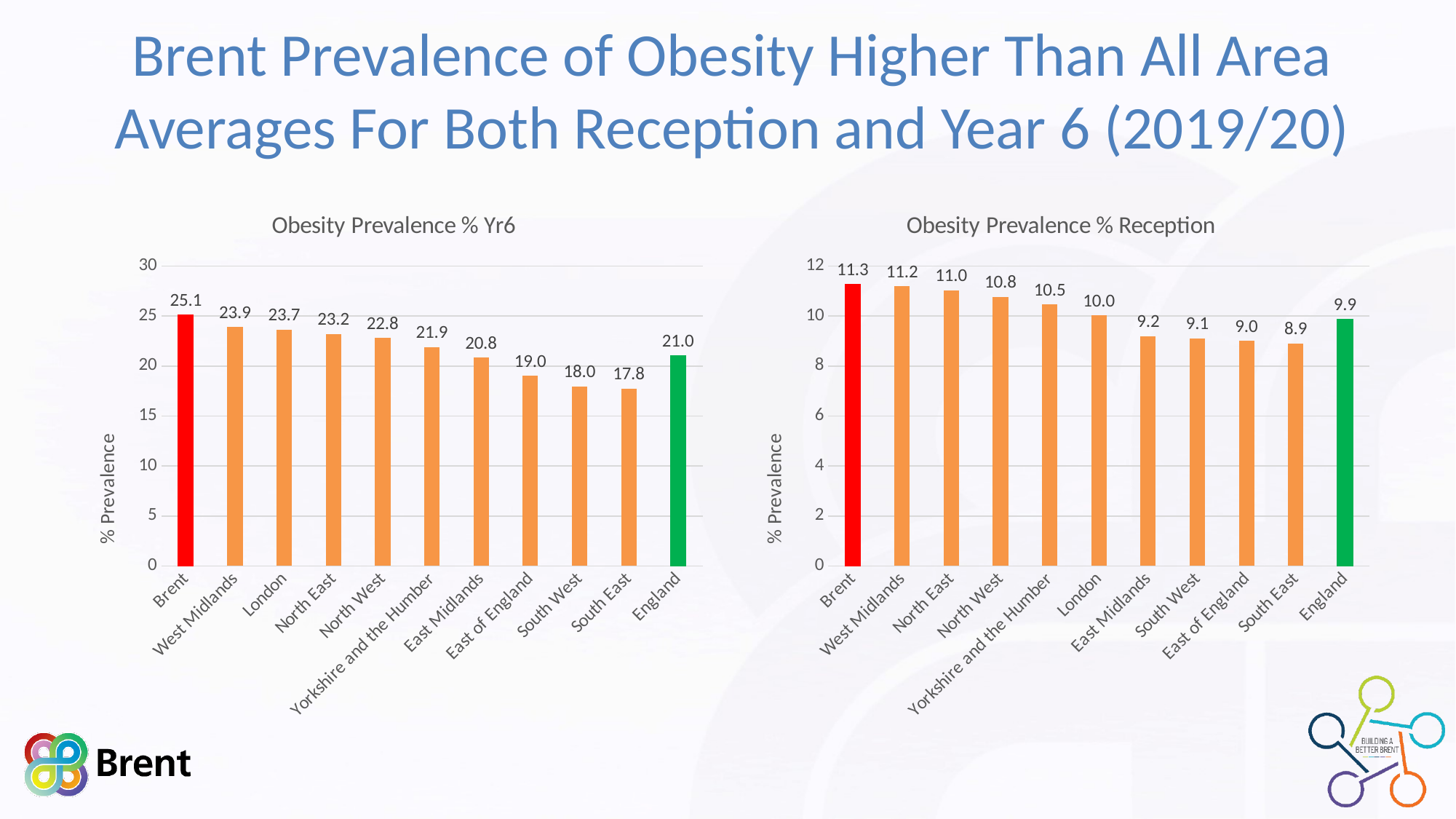
In the 'Obesity Prevalence % Reception' chart, is the value for North West greater or less than 10? greater In the 'Obesity Prevalence % Yr6' chart, what is the value for Brent? 25.1 What kind of chart is the 'Obesity Prevalence % Reception' chart? bar chart In the 'Obesity Prevalence % Yr6' chart, which category has the lowest value? South East How many categories are shown in the 'Obesity Prevalence % Yr6' chart? 11 In the 'Obesity Prevalence % Reception' chart, what is the difference between the values for Brent and South East? 2.4 In the 'Obesity Prevalence % Yr6' chart, what is the value for Yorkshire and the Humber? 21.9 In the 'Obesity Prevalence % Reception' chart, which category has the highest value? Brent In the 'Obesity Prevalence % Reception' chart, what is the value for London? 10.0 In the 'Obesity Prevalence % Yr6' chart, which is larger, the value for London or the value for East Midlands? London In the 'Obesity Prevalence % Yr6' chart, what is the difference between the values for Brent and England? 4.1 In the 'Obesity Prevalence % Reception' chart, what colour is the bar for England? green